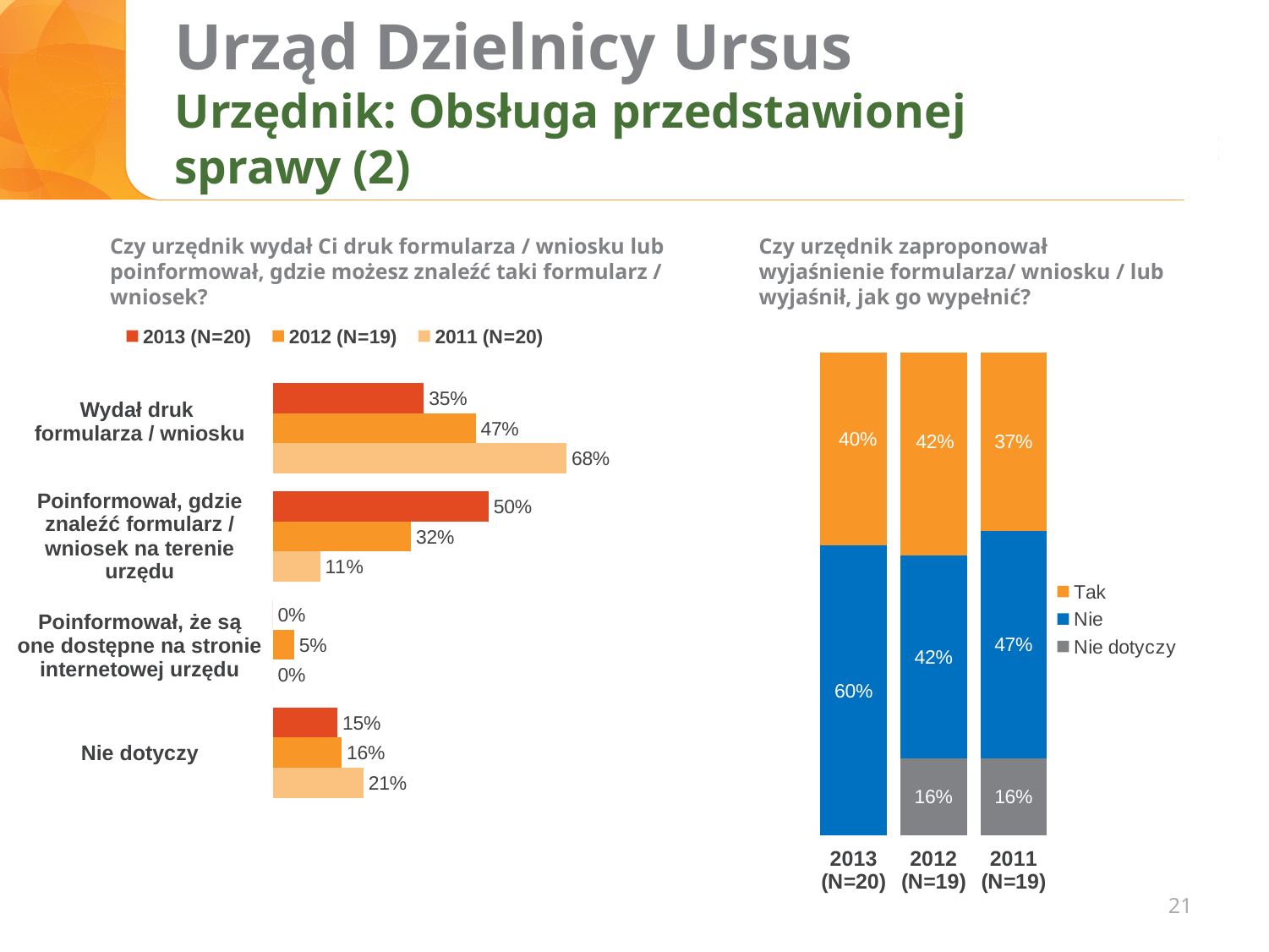
In the right chart, what is the "Tak" value for 2011 (N=19)? 37% In the left chart, which is larger for "Poinformował, gdzie znaleźć formularz / wniosek na terenie urzędu": the 2013 value or the 2012 value? 2013 How many categories are shown in the left chart? 4 How many series does the legend of the left chart list? 3 In the left chart, what is the 2011 (N=20) value for "Wydał druk formularza / wniosku"? 68% In the left chart, what is the difference between the 2011 and 2013 values for "Wydał druk formularza / wniosku"? 33% In the left chart, what is the 2013 (N=20) value for "Poinformował, gdzie znaleźć formularz / wniosek na terenie urzędu"? 50% In the left chart, what is the 2012 (N=19) value for "Nie dotyczy"? 16% What type of chart is the left chart? Bar chart In the left chart, which category has the highest 2011 (N=20) value? Wydał druk formularza / wniosku In the right chart, what is the total of the stacked bar for 2012 (N=19)? 100% In the right chart, what is the "Nie" value for 2013 (N=20)? 60%